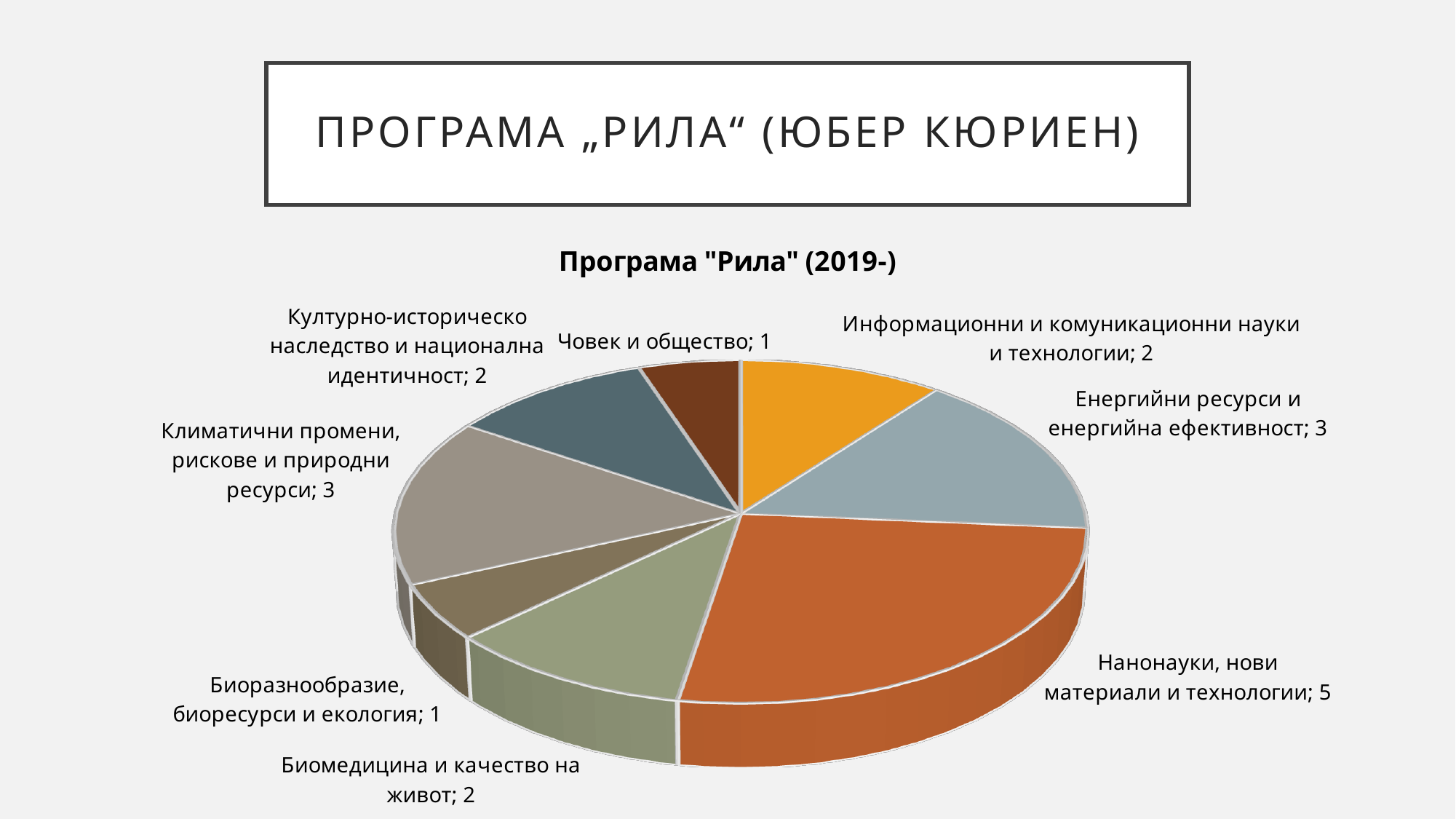
Which is larger: the value for "Енергийни ресурси и енергийна ефективност" or for "Информационни и комуникационни науки и технологии"? Енергийни ресурси и енергийна ефективност How many categories (slices) does the pie chart have? 8 Which category has the largest slice of the pie? Нанонауки, нови материали и технологии Which categories have the smallest value in the pie chart? Биоразнообразие, биоресурси и екология and Човек и общество What is the difference between the values for "Нанонауки, нови материали и технологии" and "Климатични промени, рискове и природни ресурси"? 2 What is the value for "Енергийни ресурси и енергийна ефективност"? 3 What type of chart is shown on the slide? Pie chart What is the value for "Нанонауки, нови материали и технологии"? 5 What is the total of all the values shown in the pie chart? 19 What is the title of the chart? Програма "Рила" (2019-) What is the value for "Биомедицина и качество на живот"? 2 What is the value for "Човек и общество"? 1